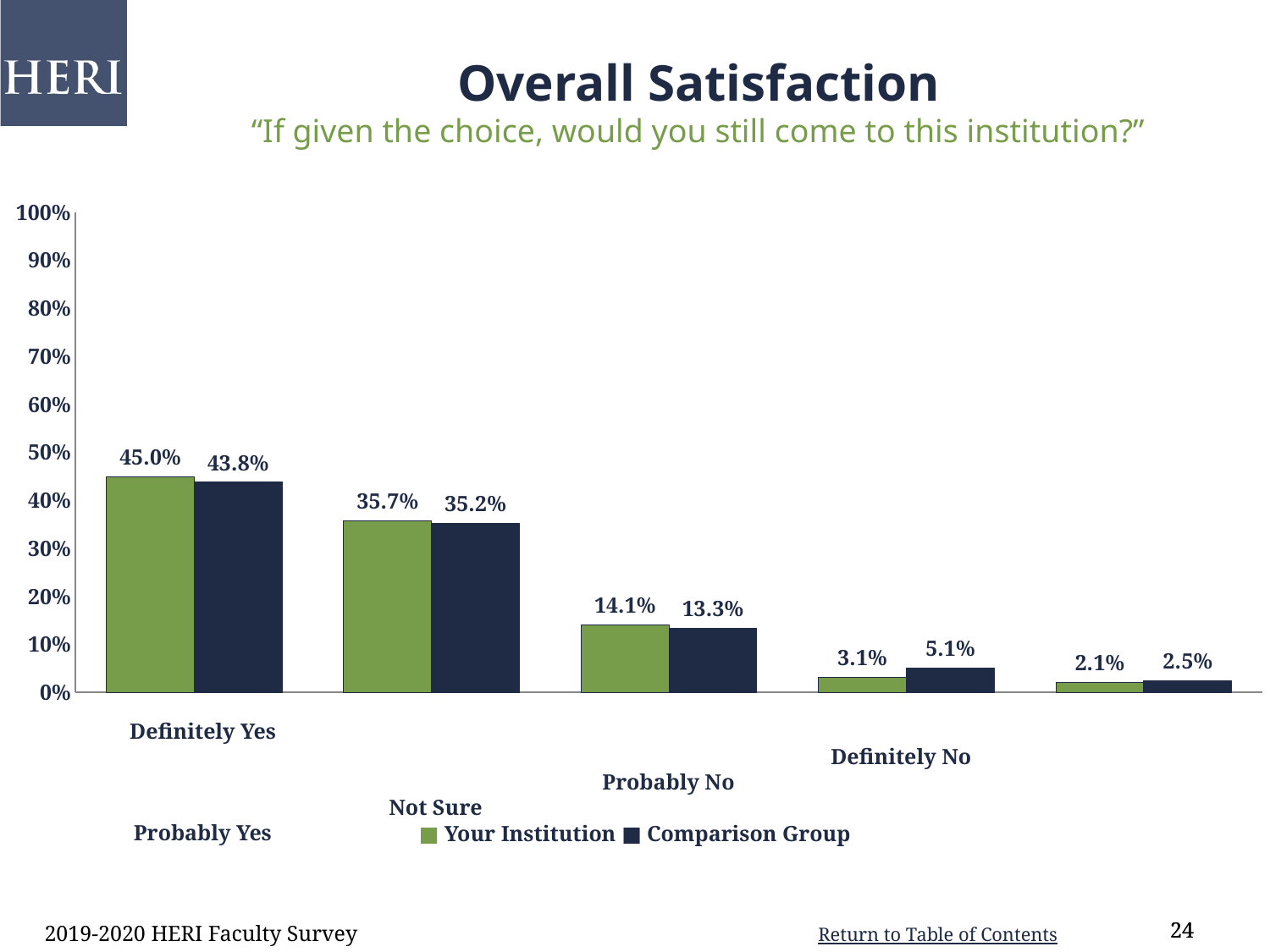
What kind of chart is shown on the slide? Bar chart What is the value for Your Institution in the Definitely Yes category? 45.0% In the Not Sure category, which is larger: Your Institution or the Comparison Group? Your Institution How many series does the legend list? 2 What is the value for the Comparison Group in the Probably Yes category? 35.2% Do the values for Your Institution rise or fall from Definitely Yes to Definitely No? Fall What is the difference between Your Institution and the Comparison Group in the Probably No category? 2.0% Which category has the lowest value for the Comparison Group? Definitely No Which category has the highest value for Your Institution? Definitely Yes How many response categories are shown on the x axis? 5 What is the value for the Comparison Group in the Definitely No category? 2.5% What is the value for Your Institution in the Not Sure category? 14.1%